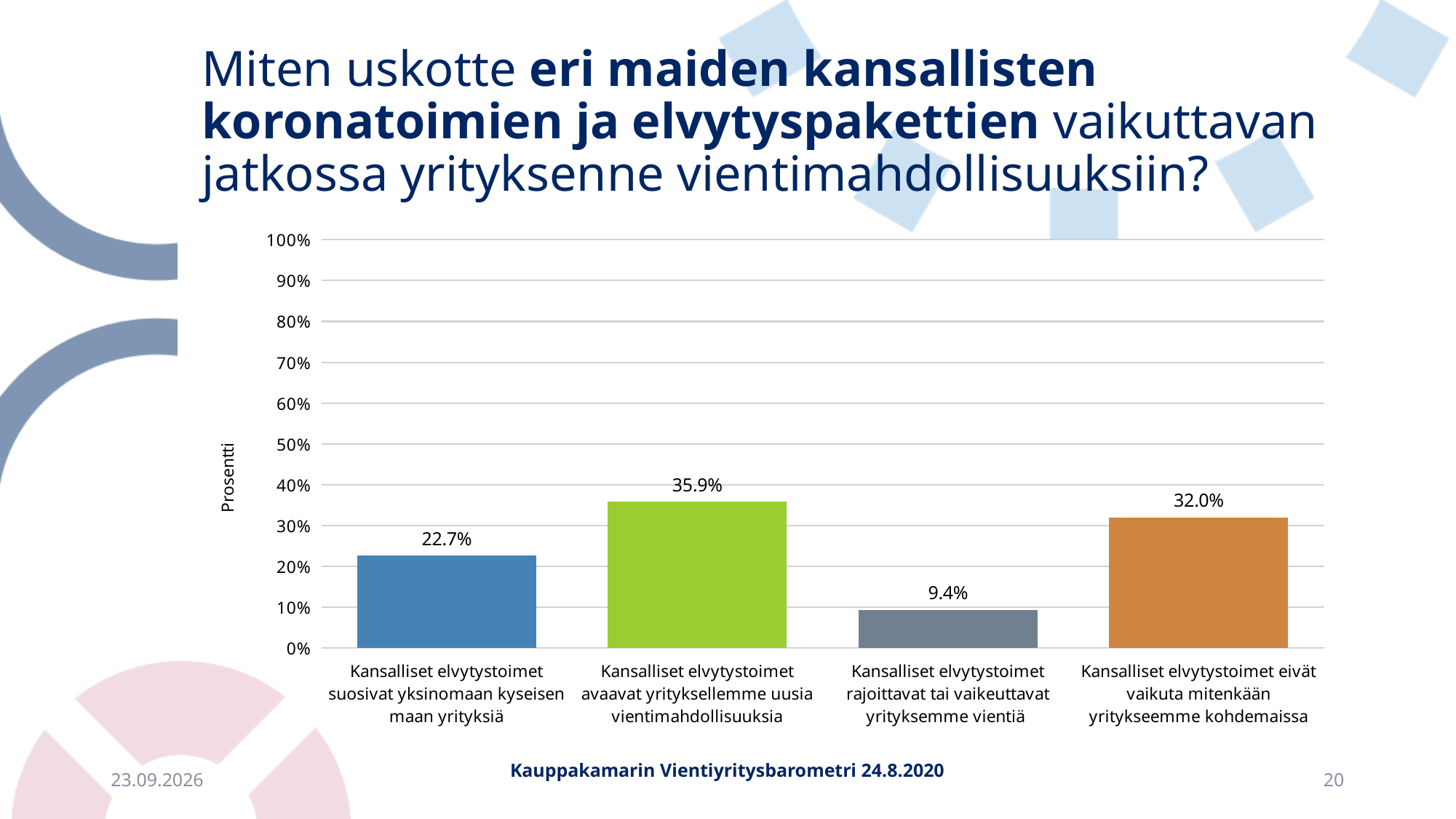
What is the label of the vertical axis? Prosentti What is the value for "Kansalliset elvytystoimet suosivat yksinomaan kyseisen maan yrityksiä"? 22.7% Which category has the lowest value? Kansalliset elvytystoimet rajoittavat tai vaikeuttavat yrityksemme vientiä What is the value for "Kansalliset elvytystoimet eivät vaikuta mitenkään yritykseemme kohdemaissa"? 32.0% What is the value for "Kansalliset elvytystoimet rajoittavat tai vaikeuttavat yrityksemme vientiä"? 9.4% What is the difference between the values for "Kansalliset elvytystoimet avaavat yrityksellemme uusia vientimahdollisuuksia" and "Kansalliset elvytystoimet eivät vaikuta mitenkään yritykseemme kohdemaissa"? 3.9% What is the value for "Kansalliset elvytystoimet avaavat yrityksellemme uusia vientimahdollisuuksia"? 35.9% Is the value for "Kansalliset elvytystoimet rajoittavat tai vaikeuttavat yrityksemme vientiä" greater or less than 10%? less How many categories are shown in the chart? 4 Which category has the highest value? Kansalliset elvytystoimet avaavat yrityksellemme uusia vientimahdollisuuksia Which is larger: the value for "Kansalliset elvytystoimet suosivat yksinomaan kyseisen maan yrityksiä" or for "Kansalliset elvytystoimet eivät vaikuta mitenkään yritykseemme kohdemaissa"? Kansalliset elvytystoimet eivät vaikuta mitenkään yritykseemme kohdemaissa What kind of chart is shown on the slide? bar chart